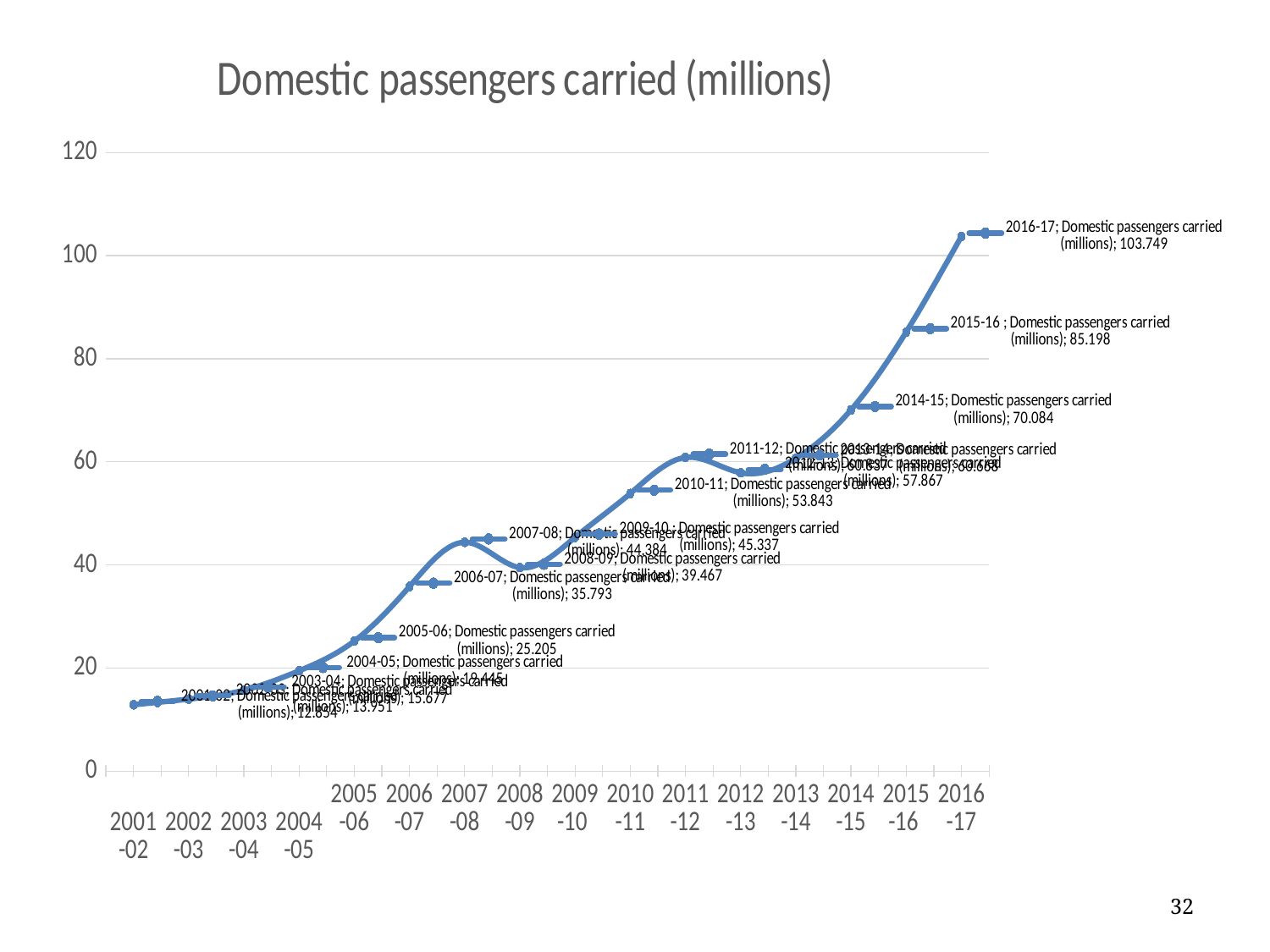
How many data points (years) are plotted on the chart? 16 Which is larger, the value for 2007-08 or the value for 2008-09? 2007-08 Which year has the highest number of domestic passengers carried? 2016-17 Which year has the lowest number of domestic passengers carried? 2001-02 Is the value for 2013-14 greater or less than 80? less What is the title of the chart? Domestic passengers carried (millions) What is the value for 2015-16? 85.198 What is the value for 2016-17? 103.749 What is the difference between the values for 2016-17 and 2015-16? 18.551 What kind of chart is shown on the slide? line chart What is the value for 2010-11? 53.843 What is the value for 2014-15? 70.084